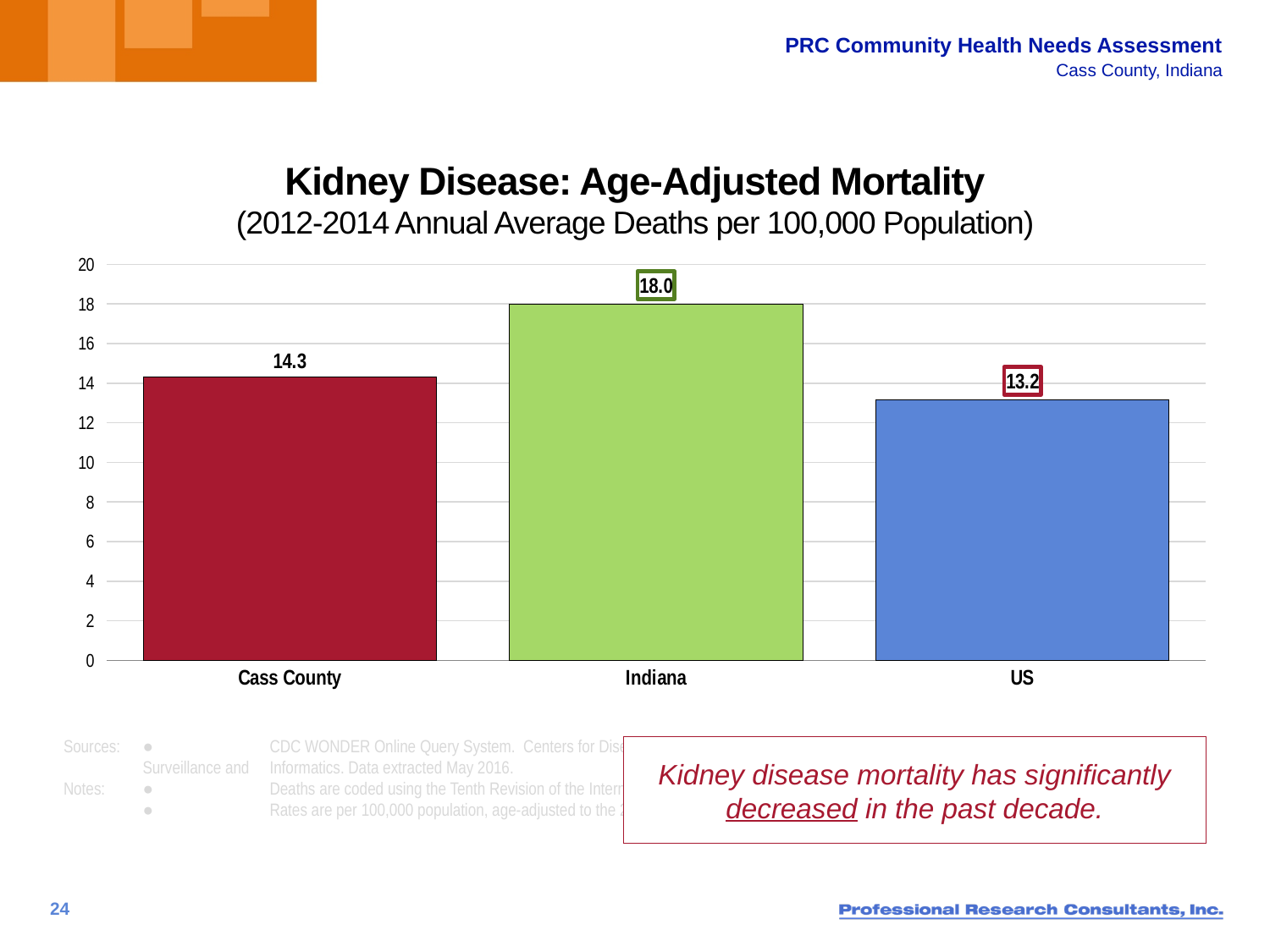
How many categories are shown in the chart? 3 What is the difference between the Cass County and US mortality rates? 1.1 What kind of chart is shown on the slide? Bar chart Is the value for Indiana greater or less than 16? greater What is the difference between the Indiana and Cass County mortality rates? 3.7 What is the kidney disease age-adjusted mortality rate for Indiana? 18.0 What is the kidney disease age-adjusted mortality rate for the US? 13.2 Which category has the highest kidney disease mortality rate? Indiana Which category has the lowest kidney disease mortality rate? US What is the title of the chart? Kidney Disease: Age-Adjusted Mortality What is the kidney disease age-adjusted mortality rate for Cass County? 14.3 Which has a higher kidney disease mortality rate, Cass County or the US? Cass County